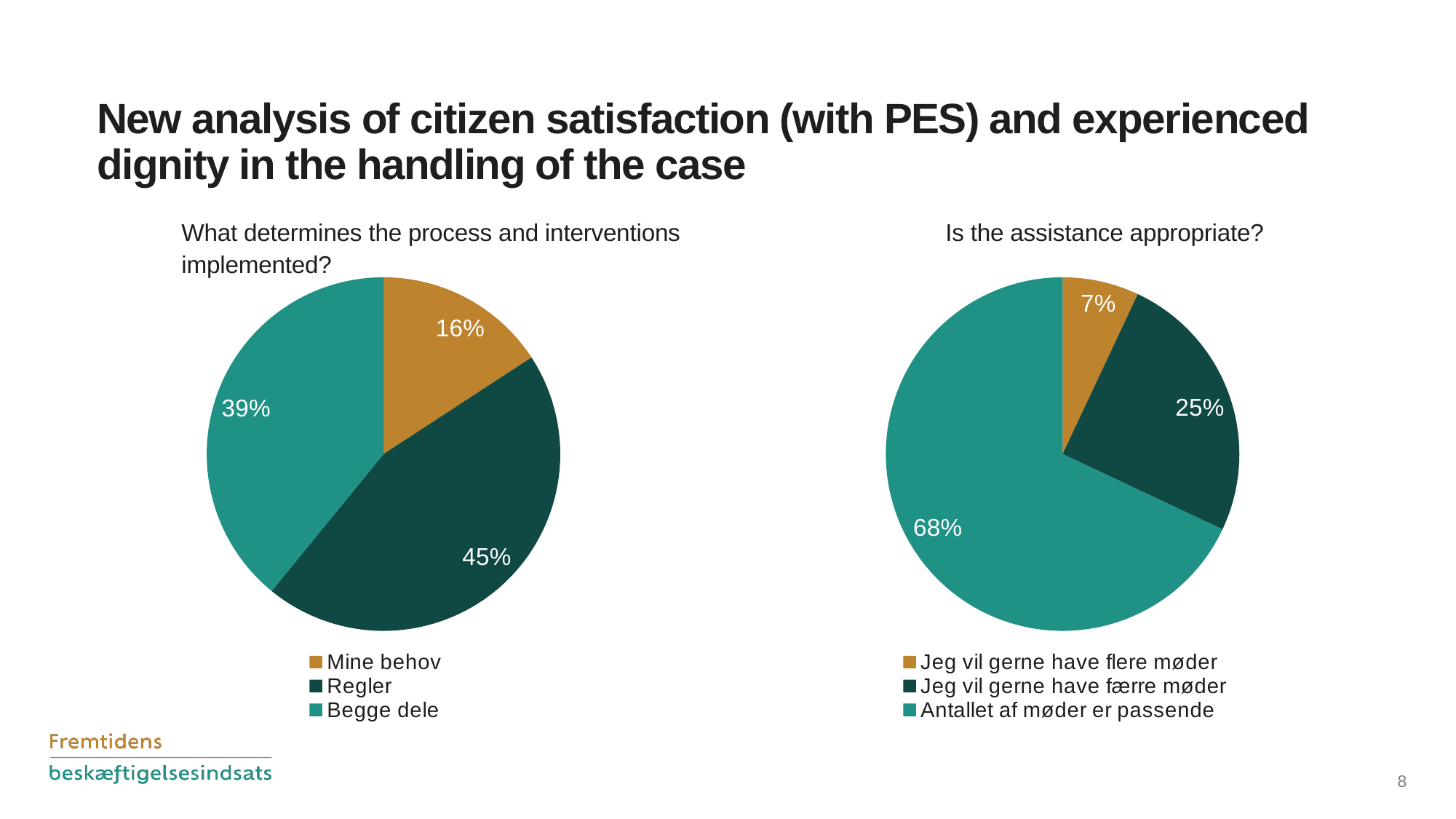
In the right chart 'Is the assistance appropriate?', which category has the smallest share? Jeg vil gerne have flere møder In the left chart 'What determines the process and interventions implemented?', what share is 'Regler'? 45% In the left chart 'What determines the process and interventions implemented?', what is the difference between the shares for 'Regler' and 'Begge dele'? 6% In the right chart 'Is the assistance appropriate?', what share is 'Antallet af møder er passende'? 68% In the left chart 'What determines the process and interventions implemented?', which category has the largest share? Regler What kind of chart is the right chart 'Is the assistance appropriate?'? Pie chart How many categories does the legend of the left chart 'What determines the process and interventions implemented?' list? 3 In the right chart 'Is the assistance appropriate?', what share is 'Jeg vil gerne have flere møder'? 7% In the right chart 'Is the assistance appropriate?', what is the difference between the shares for 'Antallet af møder er passende' and 'Jeg vil gerne have færre møder'? 43% In the right chart 'Is the assistance appropriate?', which is larger: 'Jeg vil gerne have færre møder' or 'Jeg vil gerne have flere møder'? Jeg vil gerne have færre møder In the left chart 'What determines the process and interventions implemented?', what share is 'Mine behov'? 16% In the left chart 'What determines the process and interventions implemented?', which category has the smallest share? Mine behov